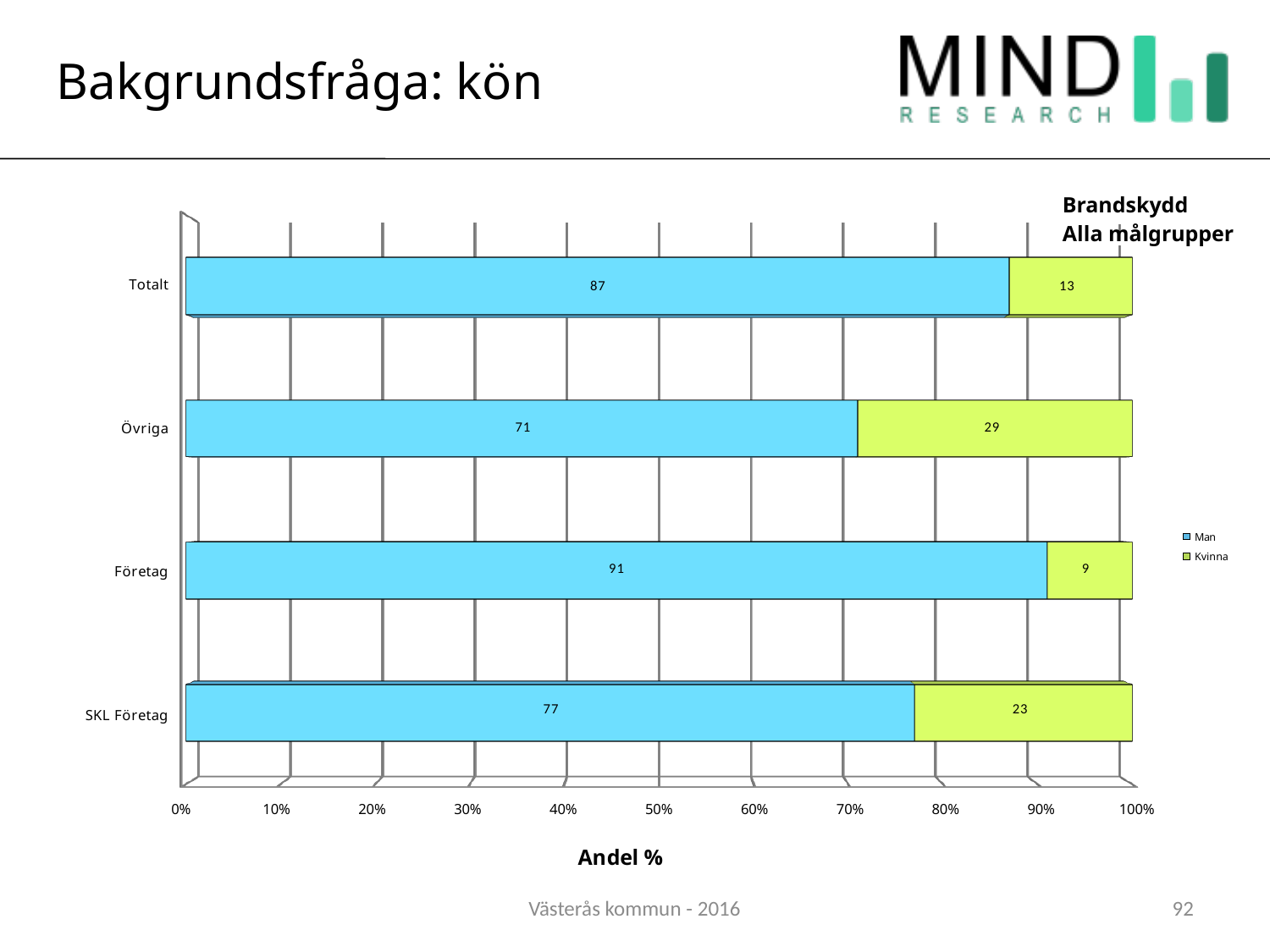
How many categories are shown on the y axis? 4 What is the value for Man in the Totalt category? 87 Which is larger, the Kvinna value for SKL Företag or for Totalt? SKL Företag Which category has the lowest value for Kvinna? Företag Which category has the highest value for Man? Företag What is the difference between the Man values for Företag and Övriga? 20 What is the total of the stacked bar for Övriga? 100 How many series does the legend list? 2 What is the label of the x axis? Andel % What is the value for Kvinna in the Övriga category? 29 What is the value for Man in the SKL Företag category? 77 What kind of chart is shown on the slide? Stacked bar chart